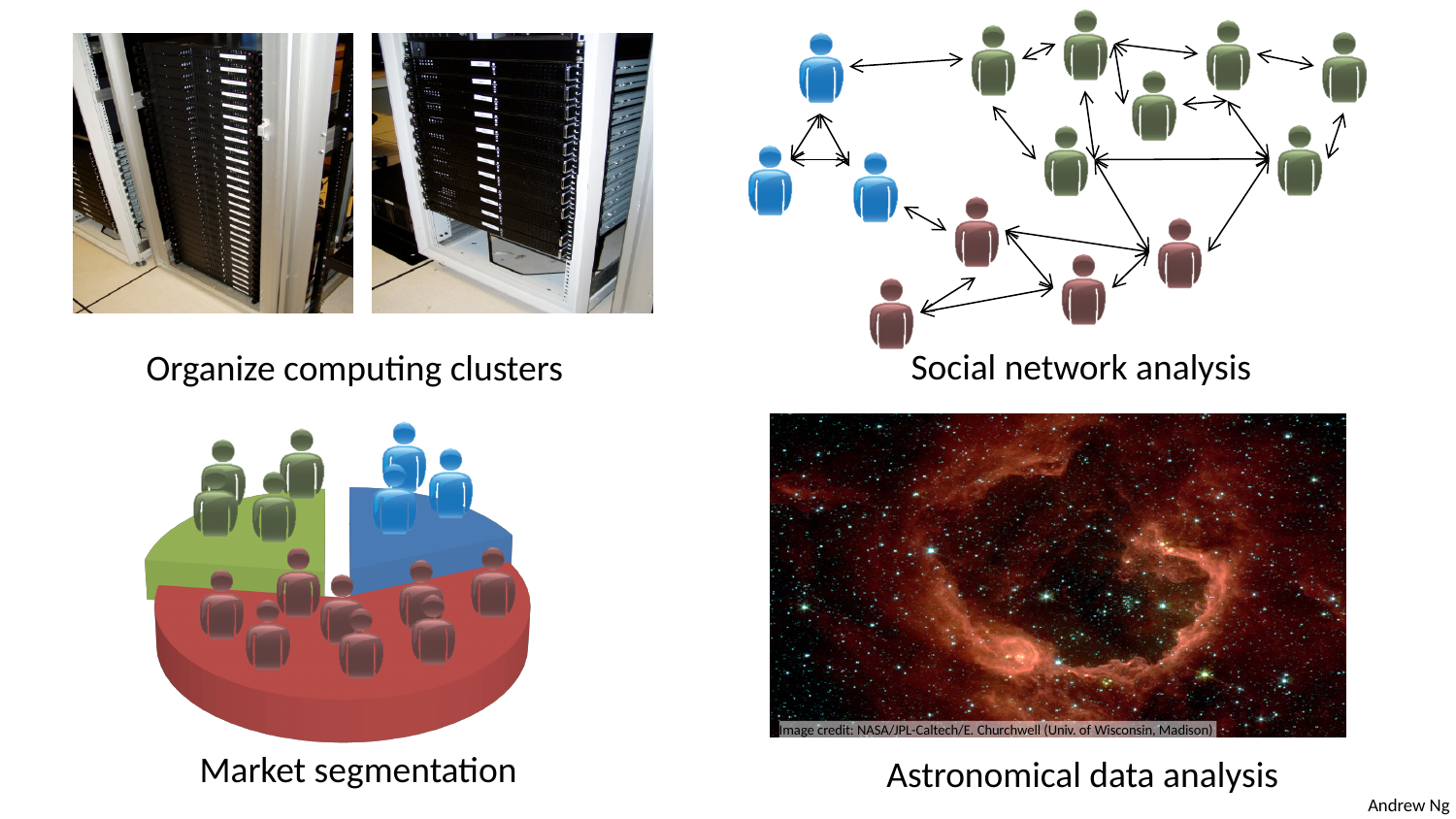
In the "Market segmentation" pie chart, which colour slice is the largest? red Does the "Market segmentation" pie chart show any data labels or percentages on its slices? No What colours are the three slices of the "Market segmentation" pie chart? green, blue and red What kind of chart is shown under the "Market segmentation" label? pie chart In the "Market segmentation" pie chart, is the red slice or the green slice larger? red In the "Market segmentation" pie chart, is the red slice or the blue slice larger? red How many slices does the "Market segmentation" pie chart have? 3